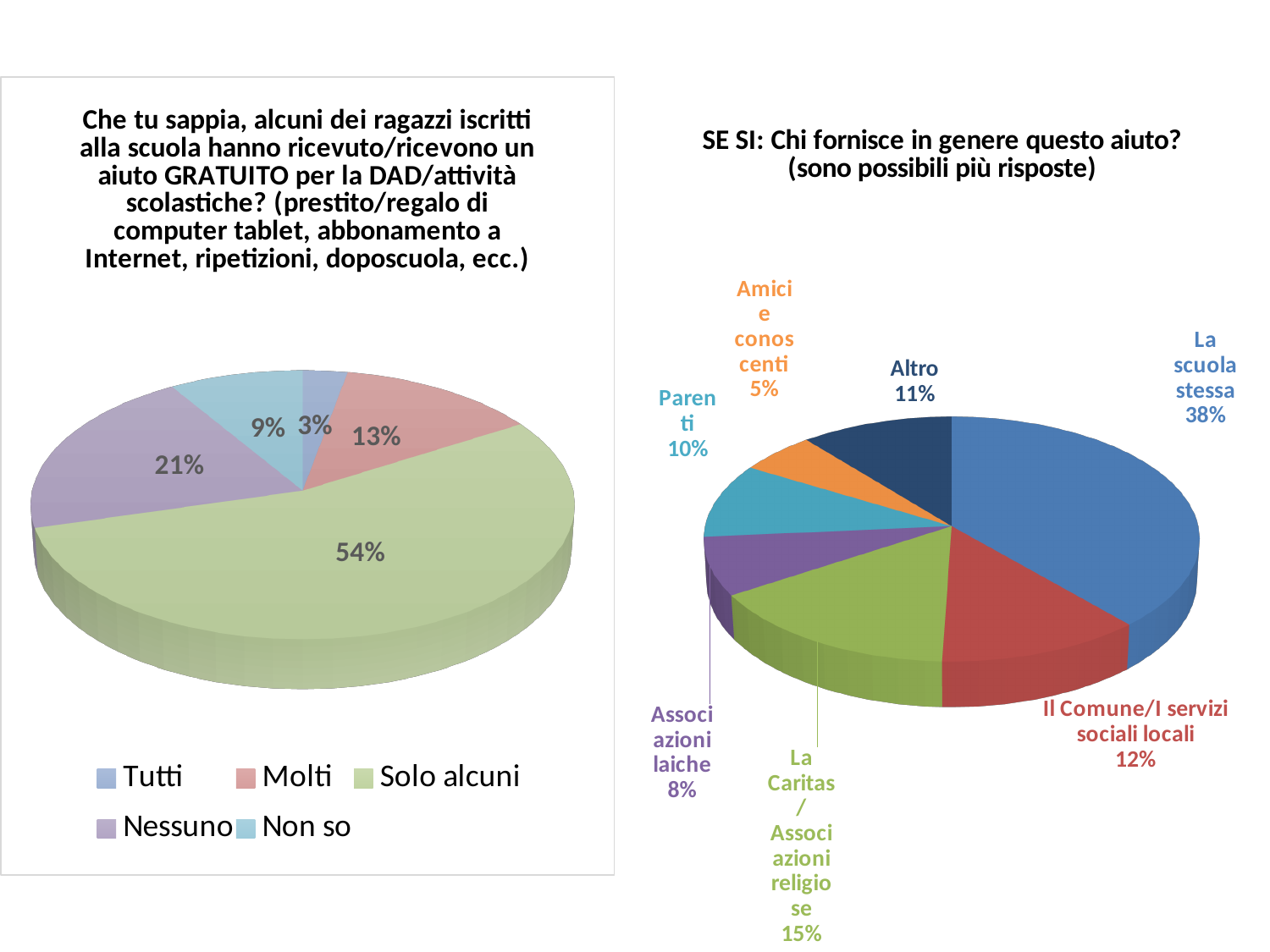
In the chart titled "SE SI: Chi fornisce in genere questo aiuto?", which is larger: "La Caritas / Associazioni religiose" or "Il Comune/I servizi sociali locali"? La Caritas / Associazioni religiose What type of chart is the left chart? Pie chart In the left pie chart, which category has the smallest share? Tutti In the left pie chart, what percentage is shown for "Nessuno"? 21% In the left pie chart, what is the difference between the shares for "Molti" and "Non so"? 4% In the left pie chart, what percentage is shown for "Solo alcuni"? 54% In the chart titled "SE SI: Chi fornisce in genere questo aiuto?", what percentage is shown for "La scuola stessa"? 38% How many categories does the legend of the left pie chart list? 5 In the chart titled "SE SI: Chi fornisce in genere questo aiuto?", which category has the smallest share? Amici e conoscenti In the chart titled "SE SI: Chi fornisce in genere questo aiuto?", which category has the largest share? La scuola stessa In the chart titled "SE SI: Chi fornisce in genere questo aiuto?", what percentage is shown for "Parenti"? 10% How many slices does the chart titled "SE SI: Chi fornisce in genere questo aiuto?" have? 7